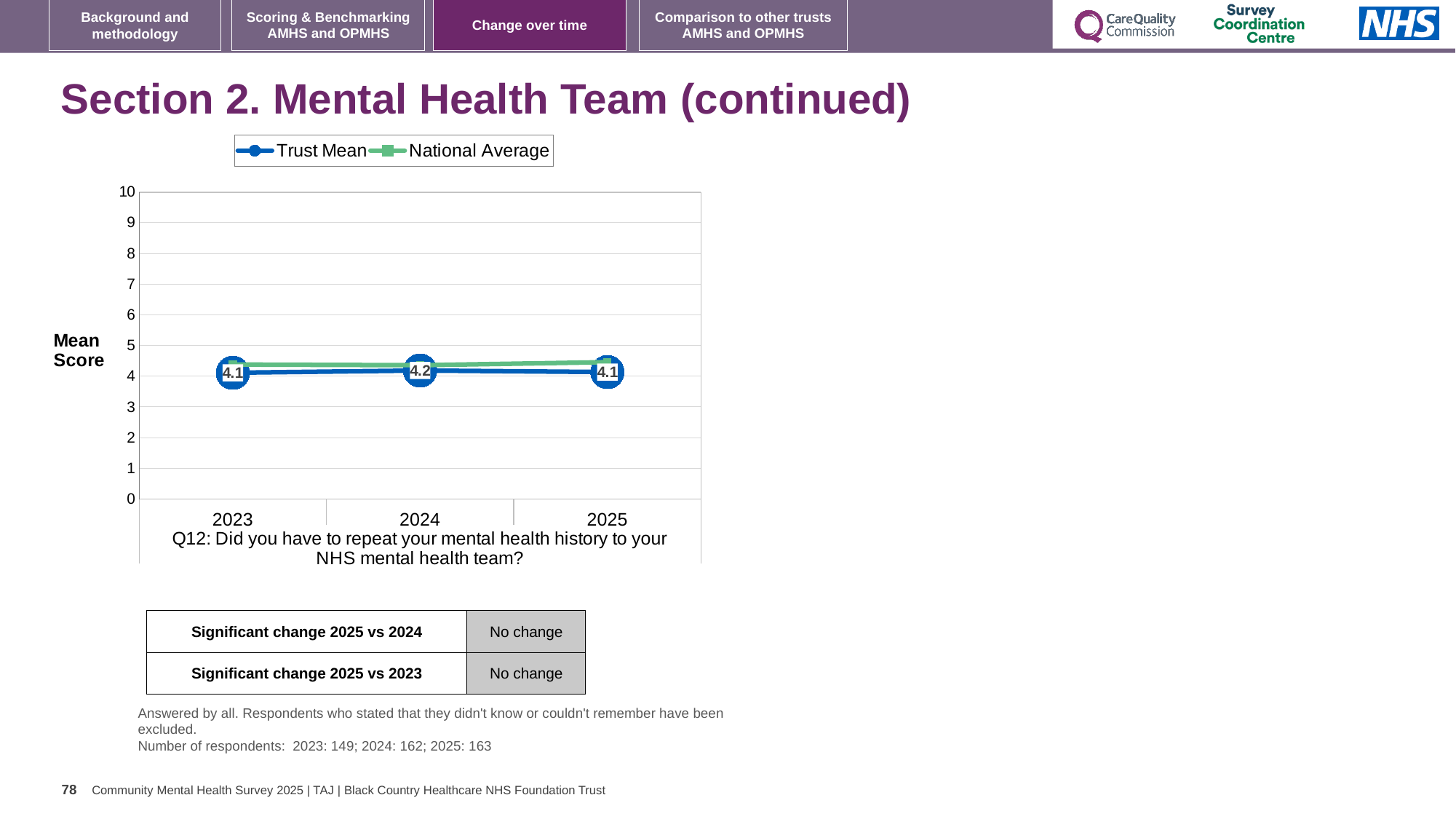
What is the label on the y axis of the chart? Mean Score How many series does the legend list? 2 What is the Trust Mean value for 2024? 4.2 How many years are plotted on the x axis? 3 What is the difference between the Trust Mean in 2024 and in 2023? 0.1 What kind of chart is shown on the slide? Line chart Is the National Average value for 2025 greater or less than 5? less What is the Trust Mean value for 2025? 4.1 Is the National Average value for 2023 greater or less than 4? greater What is the Trust Mean value for 2023? 4.1 In which year is the Trust Mean highest? 2024 In 2025, which is larger: the Trust Mean or the National Average? National Average